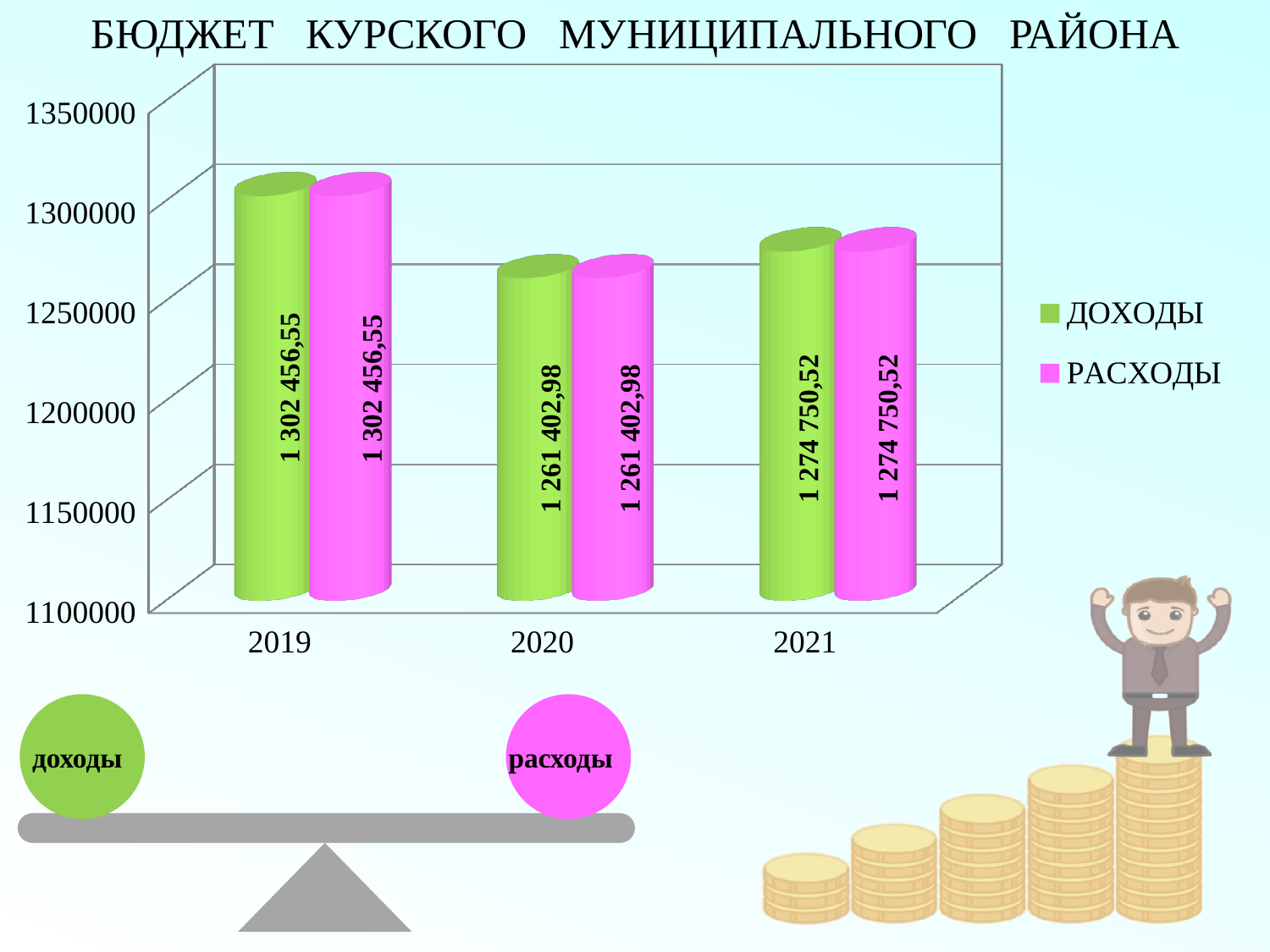
What is the value of РАСХОДЫ for 2020? 1 261 402,98 What is the difference between the ДОХОДЫ value for 2019 and the ДОХОДЫ value for 2020? 41 053,57 What kind of chart is shown on the slide? bar chart Which year has the highest value for ДОХОДЫ? 2019 How many years are shown on the x axis of the chart? 3 Which is larger, the ДОХОДЫ value for 2021 or the ДОХОДЫ value for 2020? 2021 What is the value of ДОХОДЫ for 2019? 1 302 456,55 Which year has the lowest value for РАСХОДЫ? 2020 How many series does the chart legend list? 2 What is the difference between the РАСХОДЫ value for 2021 and the РАСХОДЫ value for 2020? 13 347,54 What is the value of ДОХОДЫ for 2021? 1 274 750,52 Is the value for РАСХОДЫ in 2020 greater or less than 1300000? less